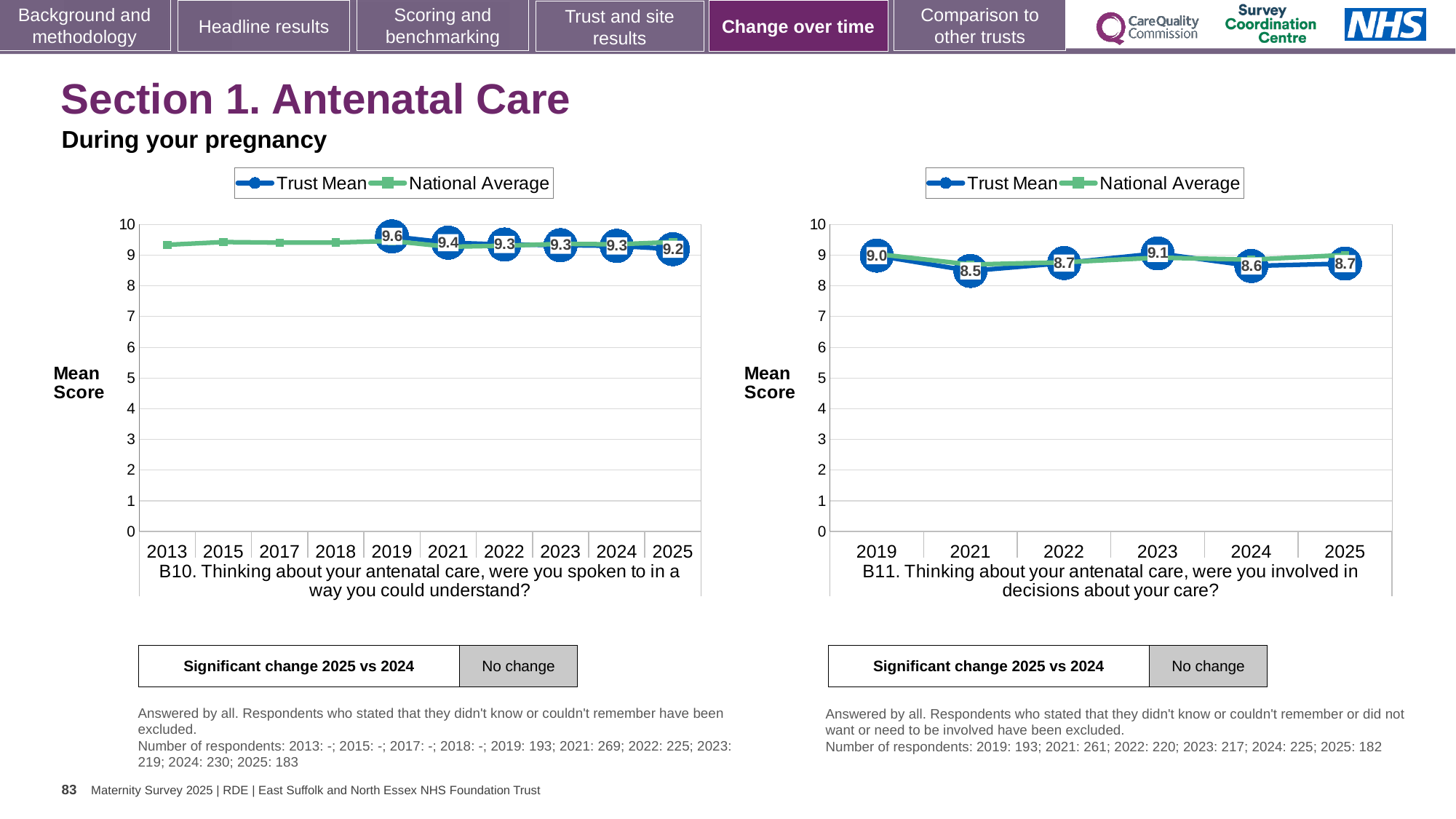
In the right chart (B11), is the Trust Mean higher in 2019 or in 2024? 2019 In the left chart (B10), what is the Trust Mean for 2025? 9.2 How many years are shown on the x axis of the right chart (B11)? 6 How many series does the legend of the left chart (B10) list? 2 In the right chart (B11), which year has the highest Trust Mean? 2023 In the right chart (B11), which year has the lowest Trust Mean? 2021 In the left chart (B10), what is the difference between the Trust Mean for 2019 and 2025? 0.4 In the right chart (B11), what is the Trust Mean for 2021? 8.5 In the right chart (B11), what is the Trust Mean for 2023? 9.1 In the left chart (B10), what is the Trust Mean for 2019? 9.6 In the left chart (B10), is the Trust Mean for 2022 greater or less than 8? greater What type of chart is the left chart (B10)? Line chart